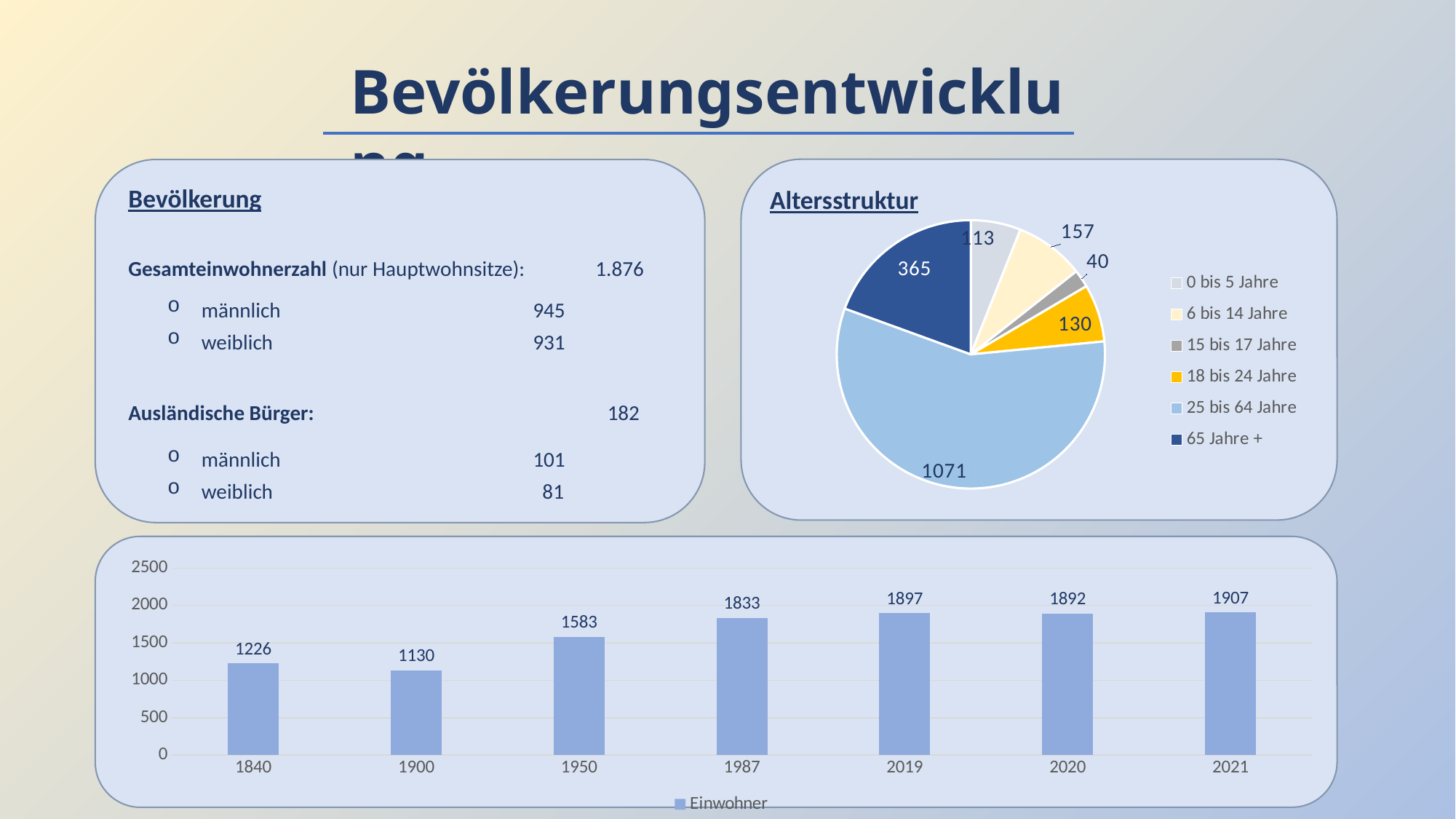
In the bottom Einwohner chart, how many years are shown on the x axis? 7 In the bottom Einwohner chart, which year has the lowest value? 1900 In the Altersstruktur pie chart, how many age groups does the legend list? 6 In the bottom Einwohner chart, what is the difference between the values for 2021 and 1840? 681 In the bottom Einwohner chart, which year has the highest value? 2021 In the Altersstruktur pie chart, which age group has the smallest slice? 15 bis 17 Jahre What kind of chart is the bottom Einwohner chart? bar chart In the Altersstruktur pie chart, what is the difference between the 6 bis 14 Jahre and 0 bis 5 Jahre values? 44 In the bottom Einwohner chart, what is the value for 1950? 1583 In the Altersstruktur pie chart, what is the value for the 65 Jahre + slice? 365 In the Altersstruktur pie chart, what is the value for the 25 bis 64 Jahre slice? 1071 In the Altersstruktur pie chart, which slice is larger: 18 bis 24 Jahre or 0 bis 5 Jahre? 18 bis 24 Jahre